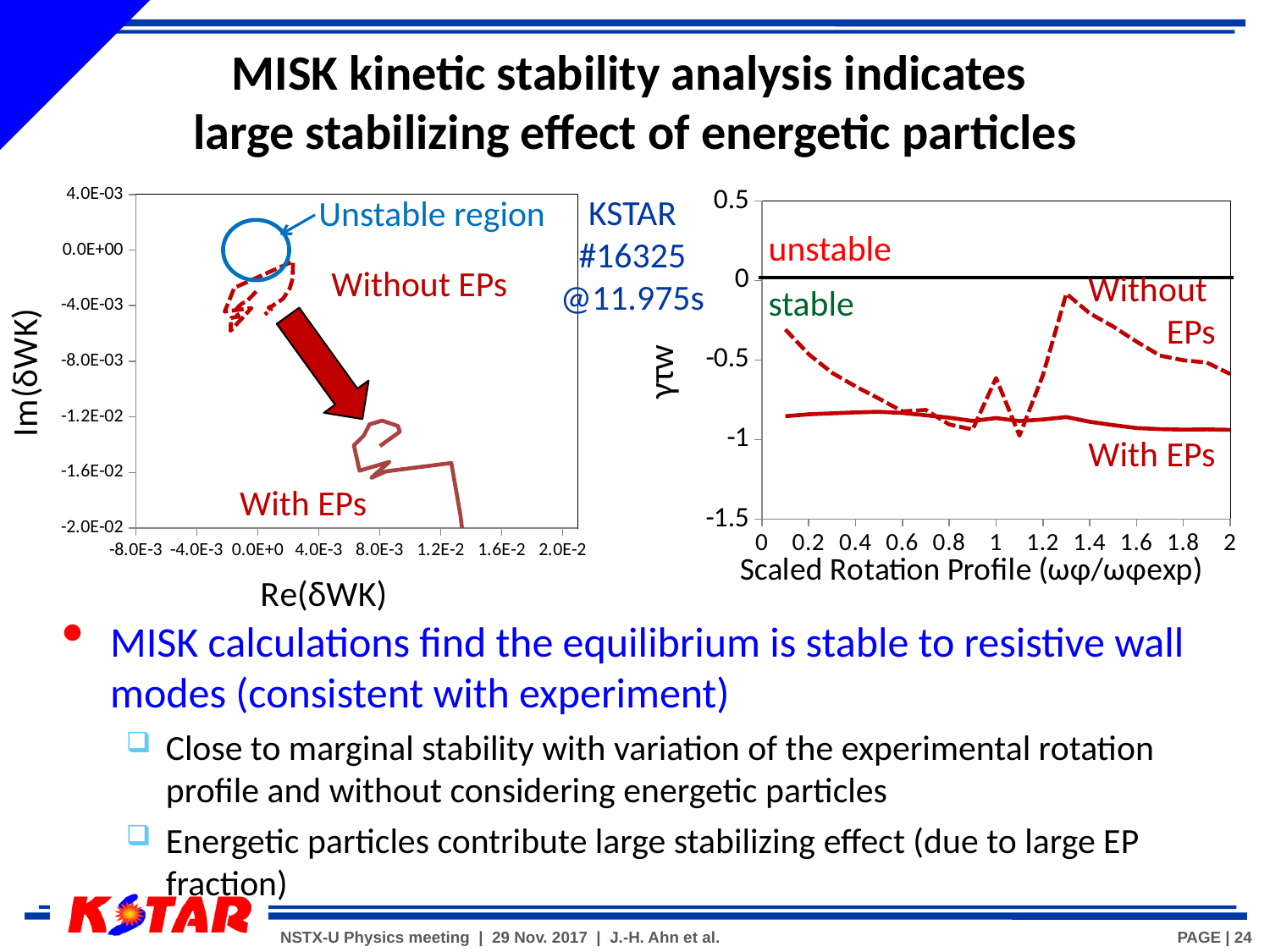
How many series are plotted on the right-hand chart (γτw versus Scaled Rotation Profile)? 2 On the right-hand chart, is the value of the Without EPs series at a scaled rotation of 0.1 greater or less than -0.5? greater On the right-hand chart, what are the names of the two plotted series? Without EPs and With EPs On the right-hand chart, what is the label of the x axis? Scaled Rotation Profile (ωφ/ωφexp) What kind of chart is the right-hand chart (γτw versus Scaled Rotation Profile)? line chart On the left-hand chart, what is the minimum value shown on the Re(δWK) axis? -8.0E-3 On the right-hand chart, is the value of the Without EPs series at a scaled rotation of 1.3 greater or less than -0.5? greater On the right-hand chart, at a scaled rotation of 2, which series has the higher γτw value, Without EPs or With EPs? Without EPs On the right-hand chart, is the value of the With EPs series at a scaled rotation of 2 greater or less than -0.5? less On the left-hand chart, what is the maximum value shown on the Im(δWK) axis? 4.0E-03 On the right-hand chart, which series reaches the highest γτw value? Without EPs